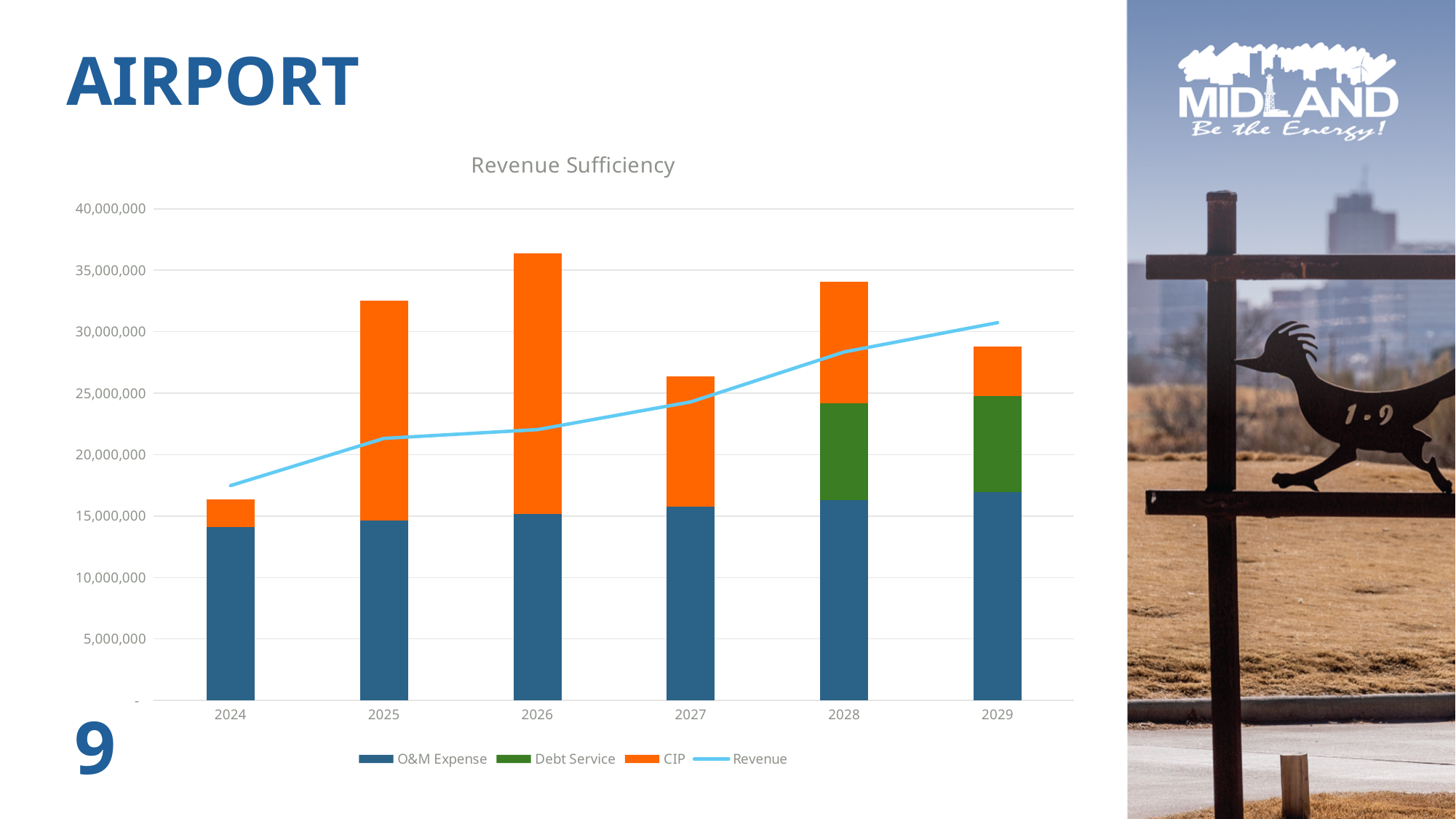
How many years are shown on the x axis? 6 Which stacked bar is taller, 2025 or 2027? 2025 Which year has the tallest stacked bar? 2026 Which year has the shortest stacked bar? 2024 Is the Revenue value for 2028 greater or less than 30,000,000? less In which years does the Debt Service segment appear in the bars? 2028 and 2029 How many series does the legend list? 4 Is the total of the stacked bar for 2024 greater or less than 20,000,000? less Does the Revenue line rise or fall from 2024 to 2029? rise Is the total of the stacked bar for 2026 greater or less than 35,000,000? greater What kind of chart is shown on the slide? A stacked bar chart with a line What is the title of the chart? Revenue Sufficiency